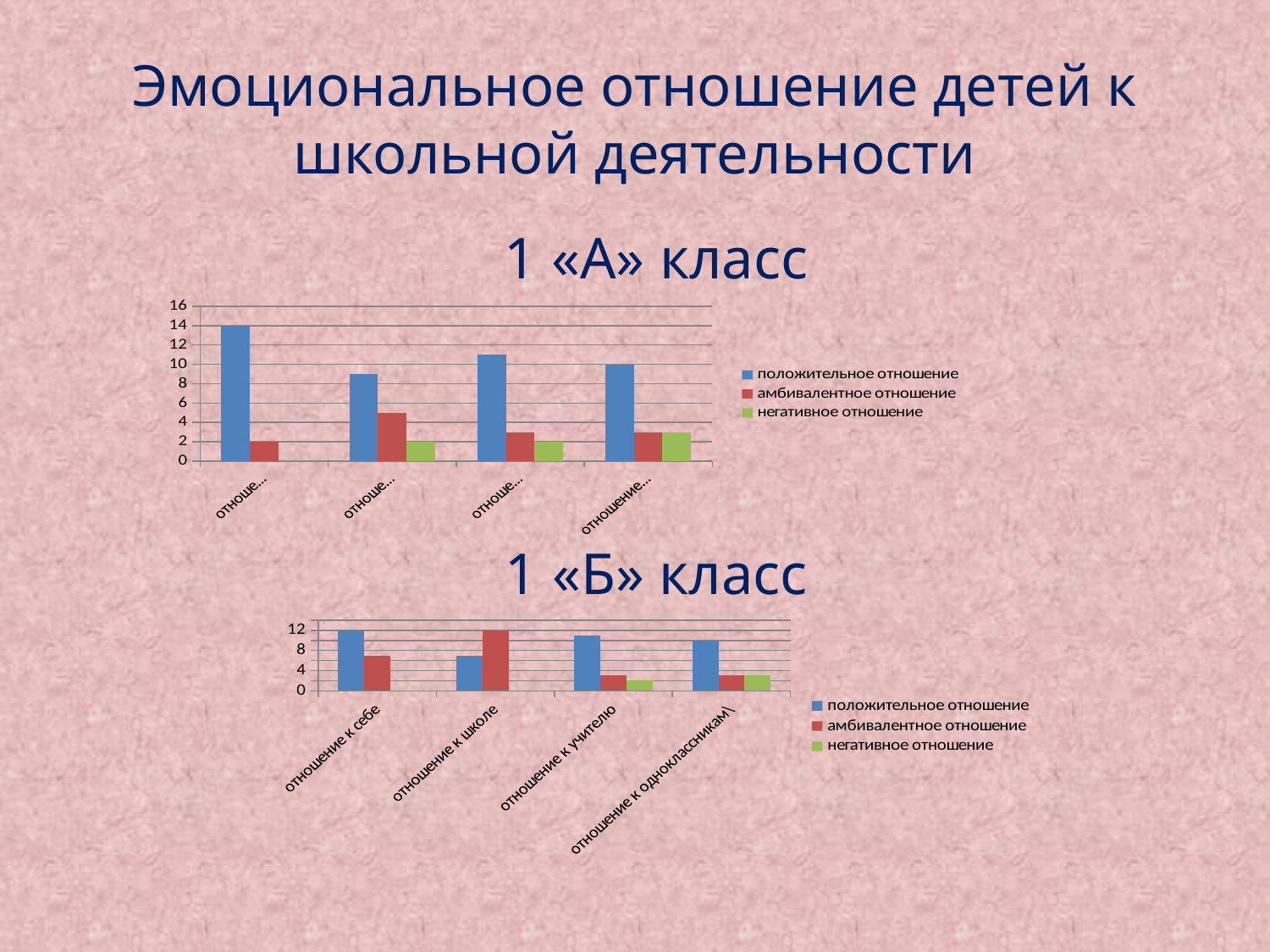
In the "1 «Б» класс" chart, what colour represents "негативное отношение"? green In the "1 «Б» класс" chart, what is the value of "положительное отношение" for "отношение к себе"? 12 In the "1 «Б» класс" chart, what is the value of "амбивалентное отношение" for "отношение к школе"? 12 In the "1 «А» класс" chart, which category has the highest value for "положительное отношение"? the first (leftmost) category In the "1 «А» класс" chart, is the value of "положительное отношение" for the second category greater or less than 8? greater In the "1 «Б» класс" chart, for "отношение к школе", which is larger: "положительное отношение" or "амбивалентное отношение"? амбивалентное отношение What kind of chart is the "1 «А» класс" chart? bar chart In the "1 «Б» класс" chart, which category has the lowest value for "положительное отношение"? отношение к школе How many categories are shown on the x axis of the "1 «Б» класс" chart? 4 How many series does the legend of the "1 «А» класс" chart list? 3 In the "1 «А» класс" chart, what is the value of "положительное отношение" for the first (leftmost) category? 14 In the "1 «Б» класс" chart, is the value of "положительное отношение" for "отношение к учителю" greater or less than 8? greater